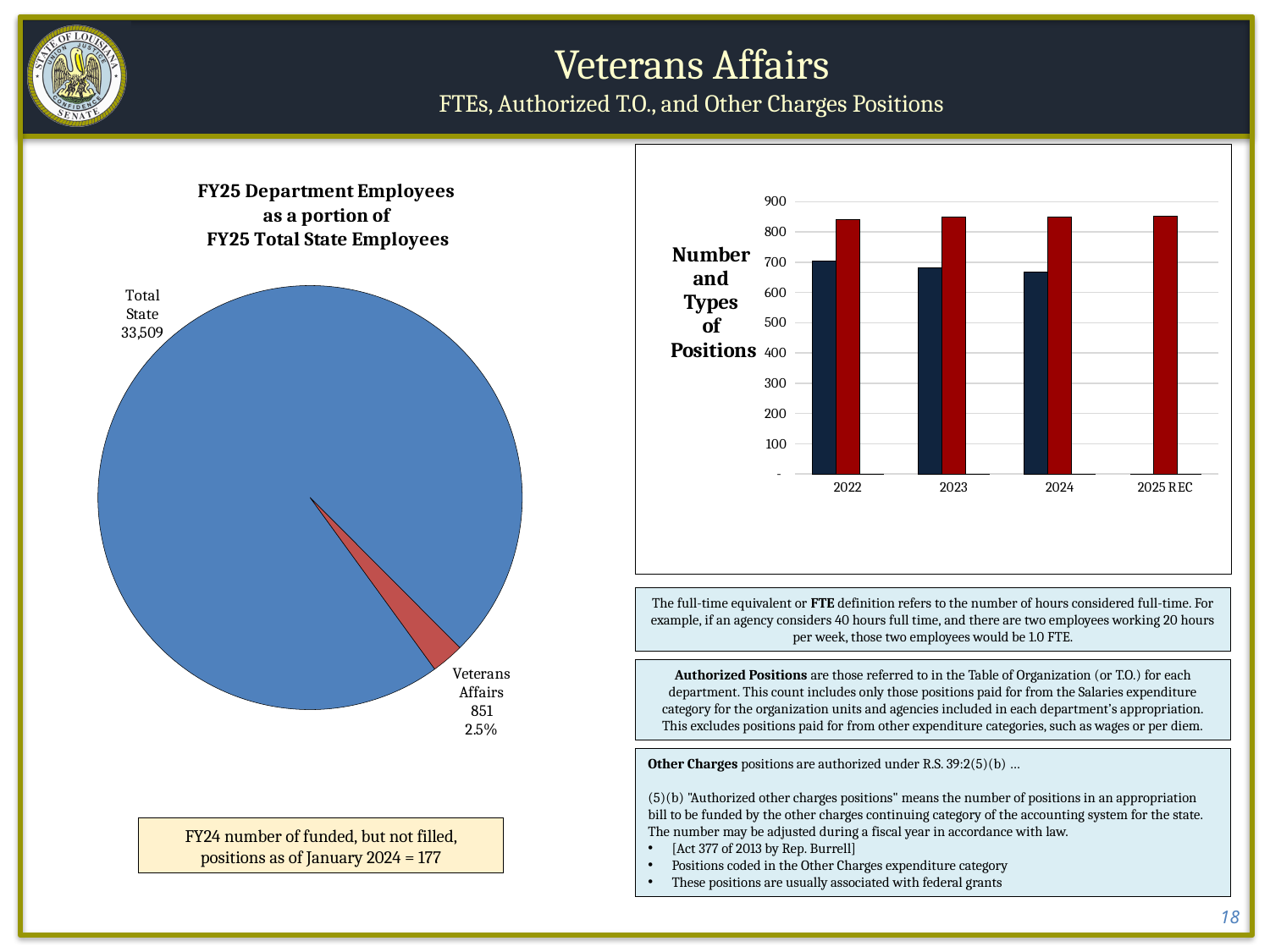
In the 'Number and Types of Positions' chart, is the dark blue bar for 2022 greater or less than 600? greater In the pie chart, which slice is larger, Total State or Veterans Affairs? Total State What kind of chart is the chart on the left side of the slide? pie chart In the 'Number and Types of Positions' chart, do the dark blue bars rise or fall from 2022 to 2024? fall In the 'Number and Types of Positions' chart, is the red bar for 2024 greater or less than 800? greater In the 'Number and Types of Positions' chart, which bar is taller for 2022, the dark blue bar or the red bar? the red bar In the pie chart, what value is shown for Total State? 33,509 In the pie chart, what share of the pie does the Veterans Affairs slice represent? 2.5% How many slices does the pie chart have? 2 In the pie chart, how many employees does the Veterans Affairs slice represent? 851 What kind of chart is the 'Number and Types of Positions' chart? bar chart How many categories are shown on the x axis of the 'Number and Types of Positions' chart? 4